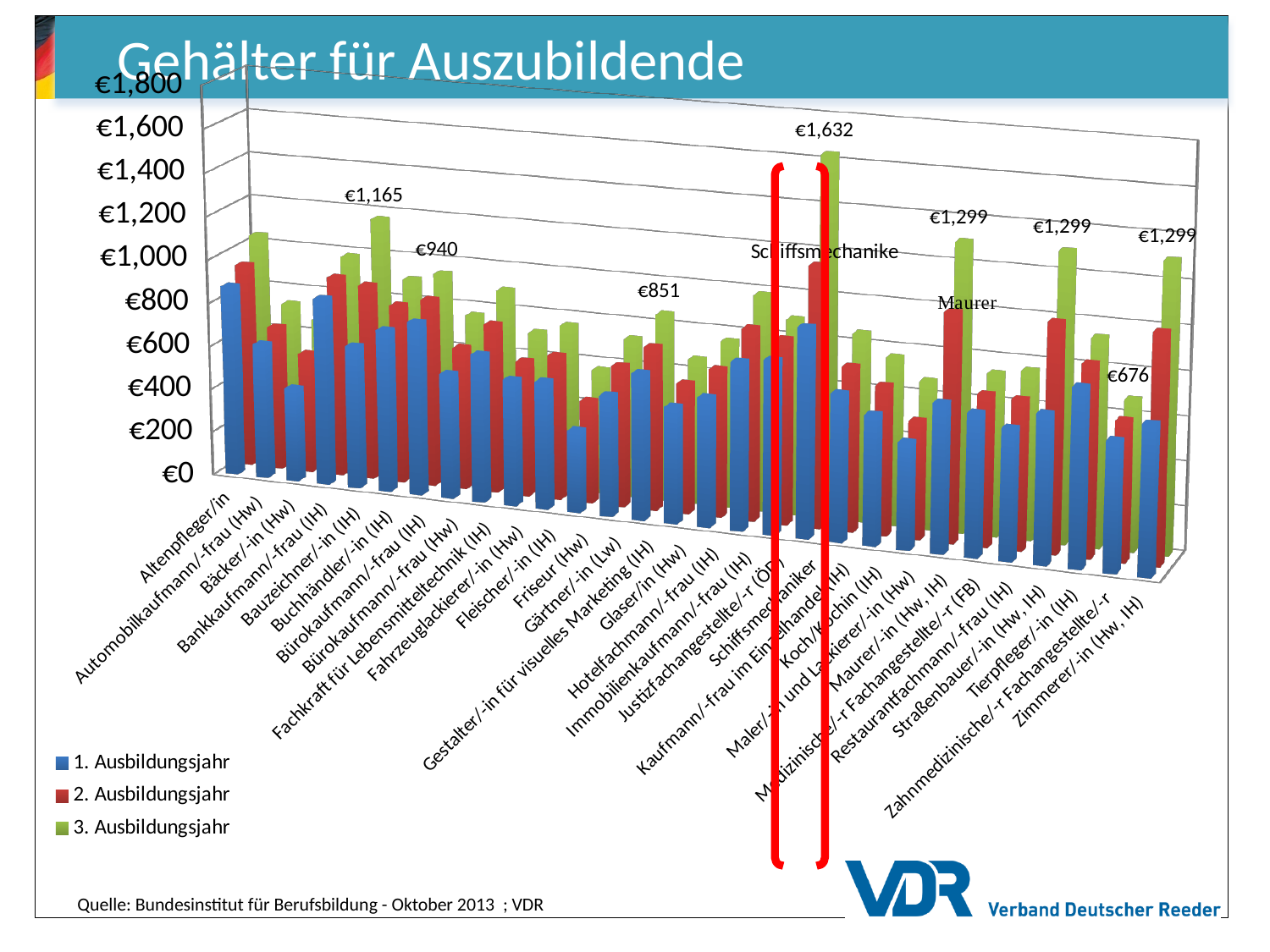
Is the 1. Ausbildungsjahr value for Friseur (Hw) greater or less than €400? less Which category has the highest value in the chart? Schiffsmechaniker Which series generally has the highest bars across the categories? 3. Ausbildungsjahr What kind of chart is shown on the slide? Bar chart How many series does the legend list? 3 Is the 3. Ausbildungsjahr value for Schiffsmechaniker greater or less than €1,400? greater Which is larger, the 3. Ausbildungsjahr value for Schiffsmechaniker or for Altenpfleger/in? Schiffsmechaniker What is the title of the chart? Gehälter für Auszubildende What is the highest value shown on the vertical axis? €1,800 What is the labelled value for Schiffsmechaniker in the 3. Ausbildungsjahr? €1,632 What are the three series listed in the legend? 1. Ausbildungsjahr, 2. Ausbildungsjahr, 3. Ausbildungsjahr